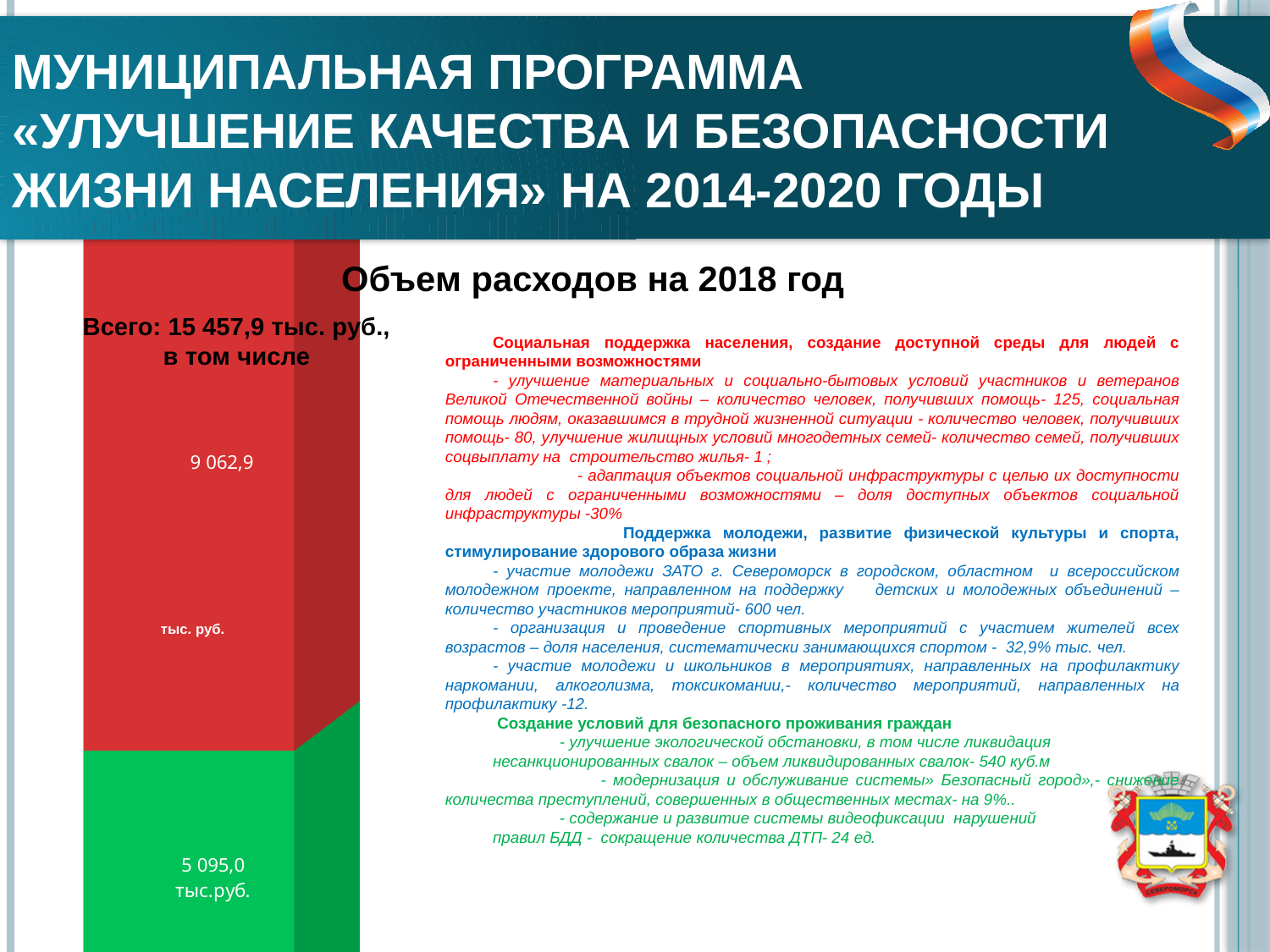
What is the difference between the red segment value (9 062,9) and the green segment value (5 095,0)? 3 967,9 What total amount is stated above the chart (Всего)? 15 457,9 тыс. руб. What value is printed on the red segment of the bar? 9 062,9 What kind of chart is shown on the left of the slide? bar chart Is the value of the red segment greater or less than 10 000? less Is the value of the green segment greater or less than 5 000? greater In what units are the values on the chart expressed? тыс. руб. Which segment of the bar has the smallest printed value? the green segment (5 095,0) What is the title of the chart on the slide? Объем расходов на 2018 год Which segment of the bar has the larger value, the red one or the green one? the red one What value is printed on the green segment of the bar? 5 095,0